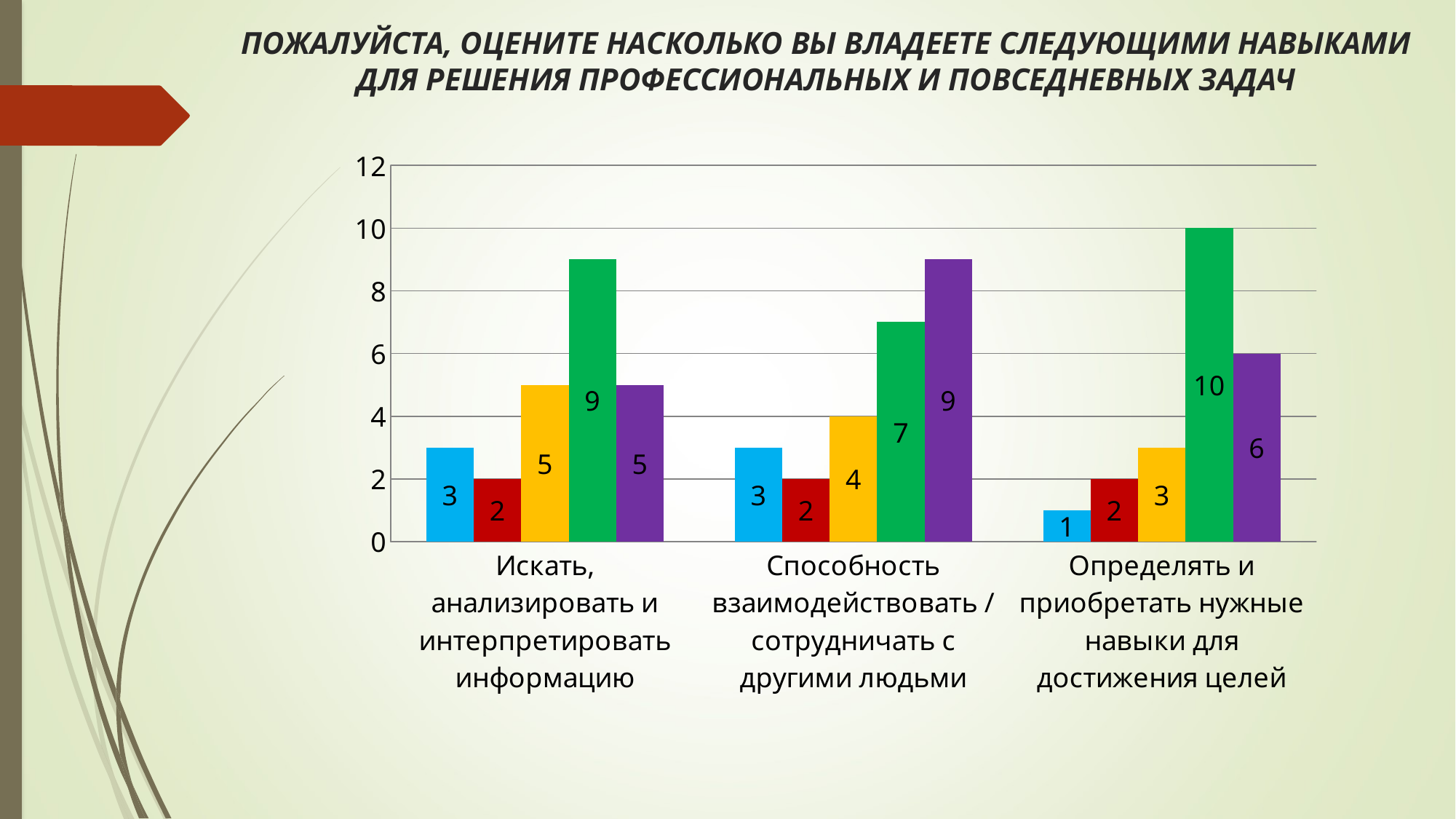
What is the total of the five bars for "Определять и приобретать нужные навыки для достижения целей"? 22 Which category has the lowest blue bar? Определять и приобретать нужные навыки для достижения целей What is the value of the blue bar for "Определять и приобретать нужные навыки для достижения целей"? 1 What is the value of the green bar for "Определять и приобретать нужные навыки для достижения целей"? 10 For "Способность взаимодействовать / сотрудничать с другими людьми", which is larger: the green bar or the purple bar? the purple bar What is the value of the purple bar for "Способность взаимодействовать / сотрудничать с другими людьми"? 9 What kind of chart is shown on the slide? bar chart Which category has the highest green bar? Определять и приобретать нужные навыки для достижения целей What is the difference between the green bar and the purple bar for "Искать, анализировать и интерпретировать информацию"? 4 What is the maximum value shown on the vertical axis of the chart? 12 How many bars are plotted for each category in the chart? 5 How many categories are shown on the x axis of the chart? 3